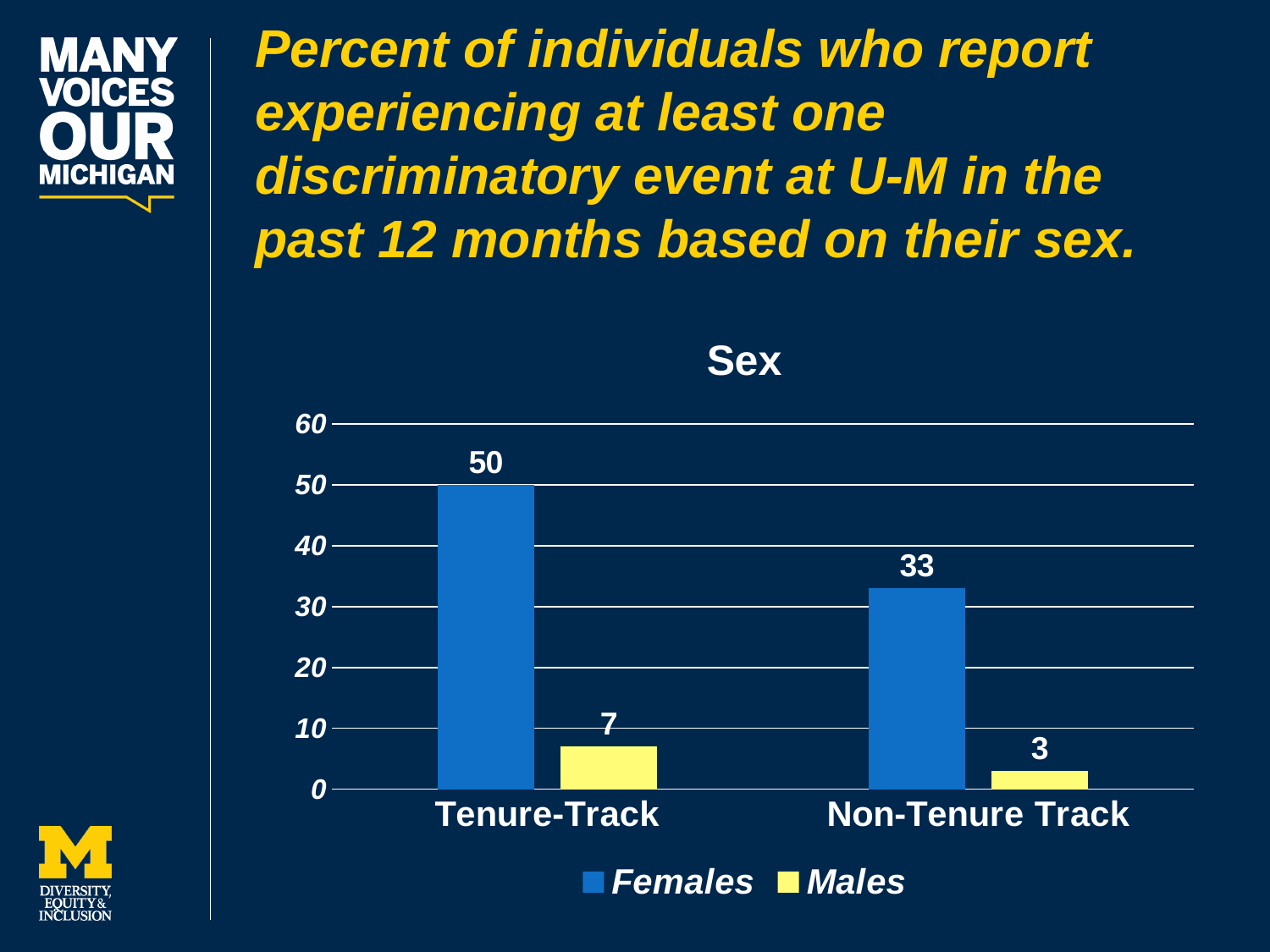
What is the value for Females in the Tenure-Track category? 50 Which bar has the highest value on the chart? Females, Tenure-Track Which is larger: the Males value for Tenure-Track or the Males value for Non-Tenure Track? Tenure-Track How many series does the legend list? 2 What is the value for Females in the Non-Tenure Track category? 33 What is the value for Males in the Non-Tenure Track category? 3 What is the difference between the Females and Males values in the Tenure-Track category? 43 What is the value for Males in the Tenure-Track category? 7 Which bar has the lowest value on the chart? Males, Non-Tenure Track How many categories are shown on the x axis? 2 What kind of chart is shown on the slide? Bar chart What is the difference between the Females values for Tenure-Track and Non-Tenure Track? 17